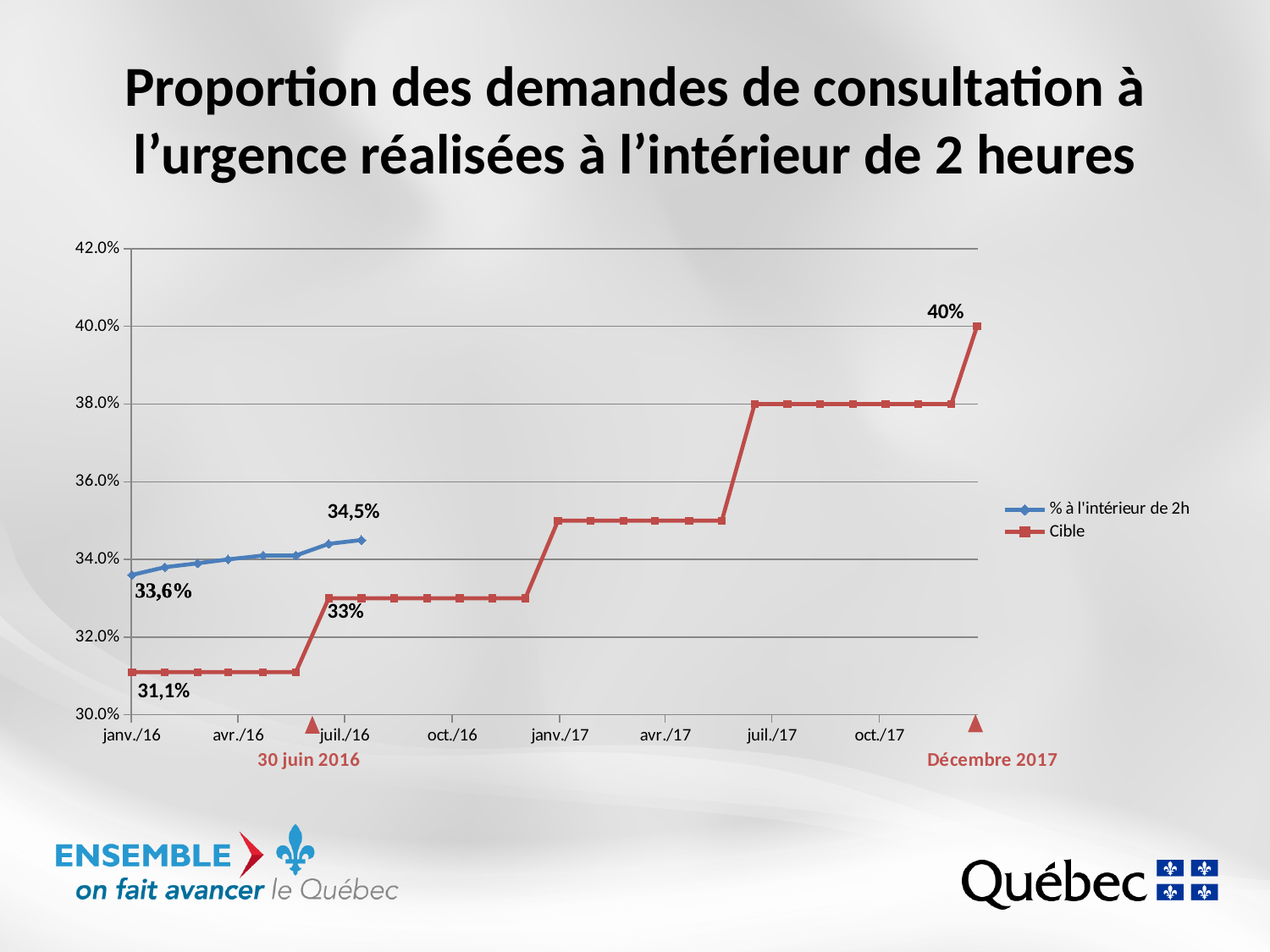
Is the Cible value at avr./17 greater or less than 34.0%? greater What is the Cible value labelled just after 30 juin 2016? 33% What is the Cible value at oct./17? 38.0% What is the first labelled value of the '% à l'intérieur de 2h' series, at janv./16? 33,6% What are the two series named in the legend? % à l'intérieur de 2h and Cible What is the starting value of the Cible series at janv./16? 31,1% What kind of chart is shown on the slide? line chart How many series does the legend list? 2 What is the value of the Cible series at Décembre 2017? 40% By how many percentage points does the Cible series rise from its starting value (31,1%) to its final value (40%)? 8,9 At janv./16, which series has the larger value, '% à l'intérieur de 2h' or Cible? % à l'intérieur de 2h What is the last labelled value of the '% à l'intérieur de 2h' series, near 30 juin 2016? 34,5%